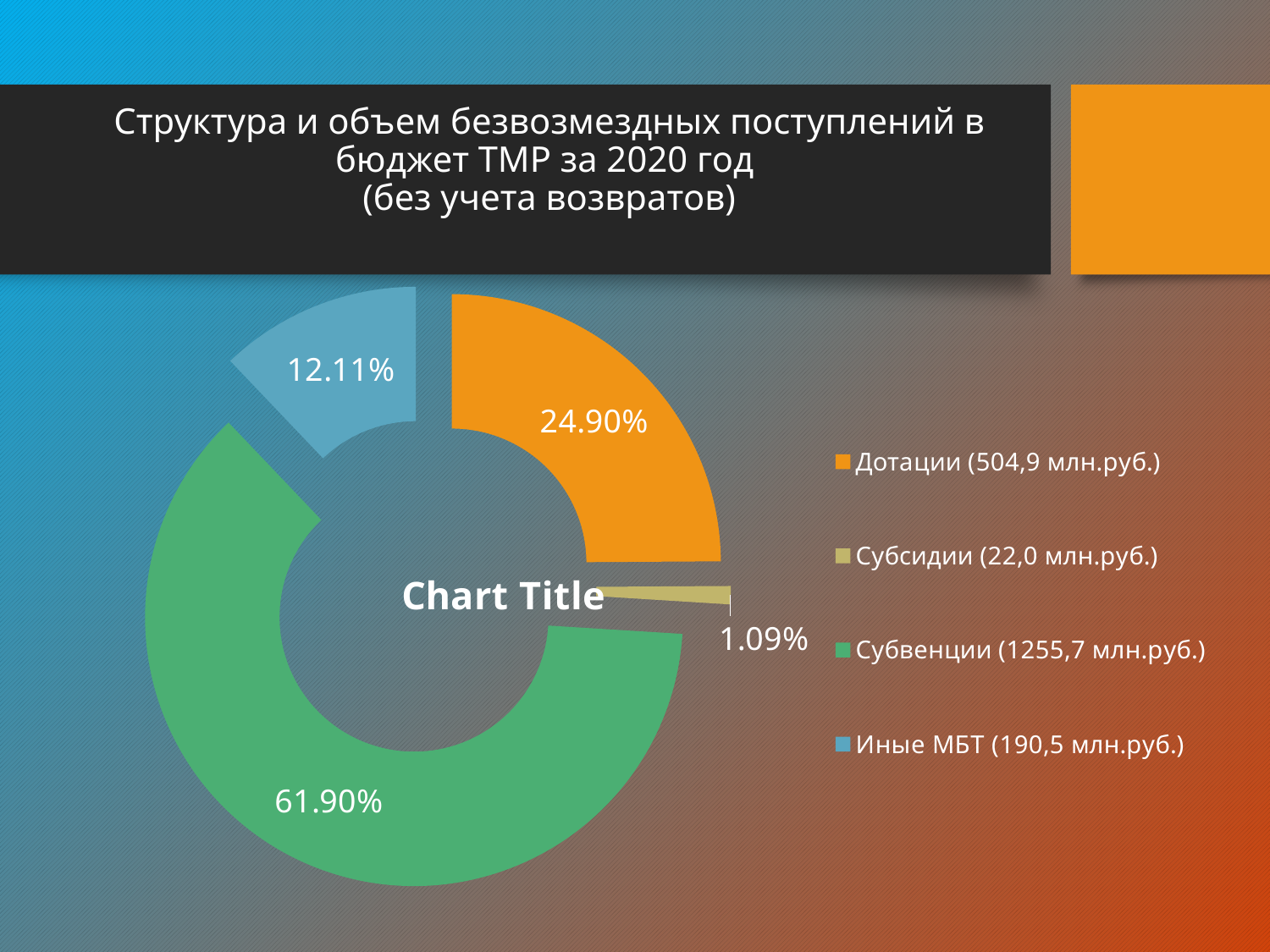
What is the difference in percentage points between the shares of Субвенции and Дотации? 37.00% What share of the chart does Иные МБТ (190,5 млн.руб.) account for? 12.11% Which category has the smallest share of the chart? Субсидии (22,0 млн.руб.) What share of the chart does Дотации (504,9 млн.руб.) account for? 24.90% Which category has the largest share of the chart? Субвенции (1255,7 млн.руб.) How many categories does the chart show? 4 What share of the chart does Субсидии (22,0 млн.руб.) account for? 1.09% Which has a larger share, Дотации or Иные МБТ? Дотации What is the difference in percentage points between the shares of Иные МБТ and Субсидии? 11.02% What colour is the slice for Субвенции (1255,7 млн.руб.)? green What kind of chart is shown on the slide? doughnut (pie) chart